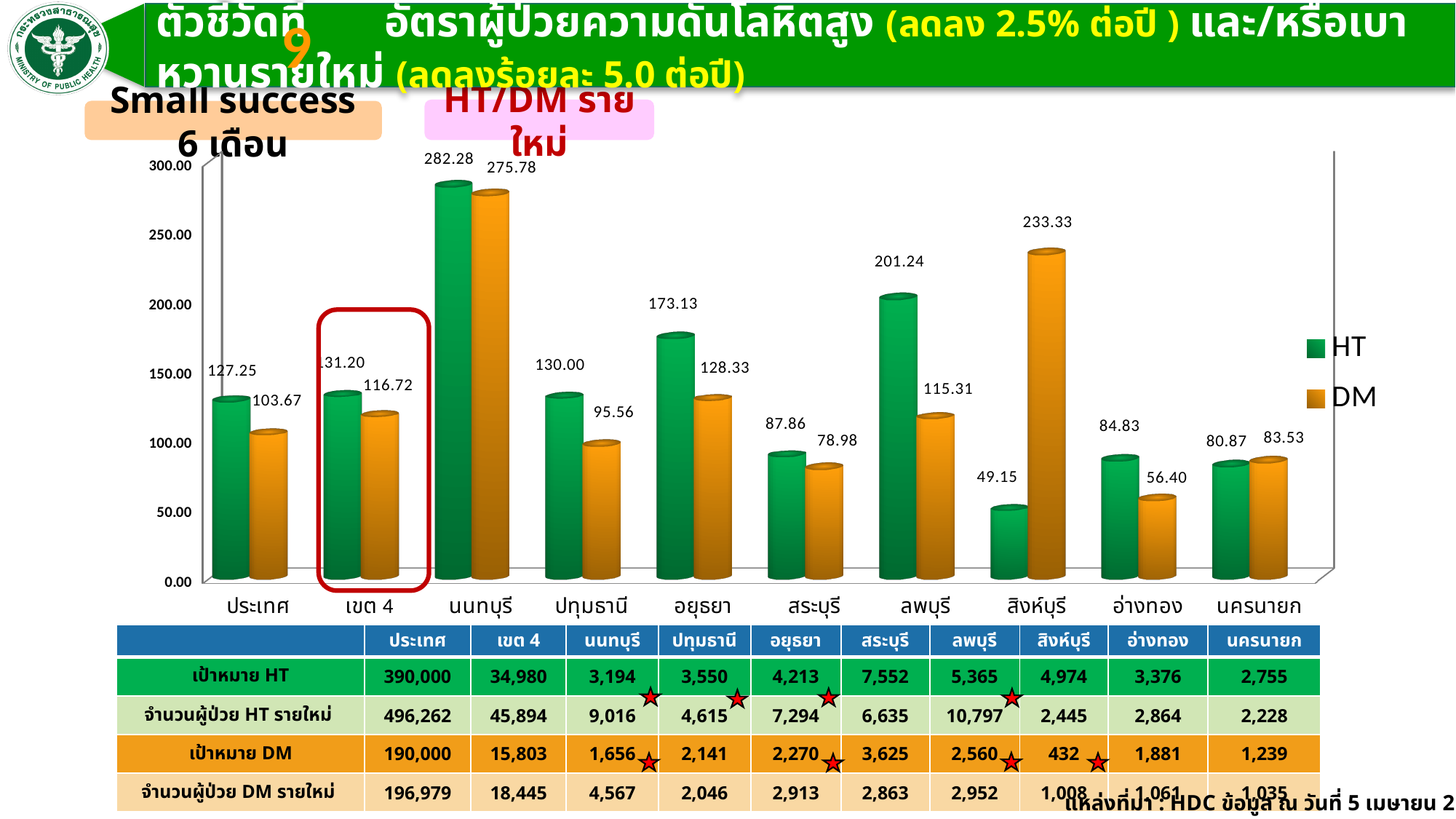
What is the HT value for นนทบุรี? 282.28 What is the HT value for เขต 4? 131.20 What is the DM value for ประเทศ? 103.67 Which category has the highest HT value? นนทบุรี What kind of chart is shown on the slide? Bar chart How many categories are shown on the x axis of the chart? 10 Which category has the lowest HT value? สิงห์บุรี What is the difference between the HT and DM values for ลพบุรี? 85.93 How many series does the chart legend list? 2 Which category has the lowest DM value? อ่างทอง What is the DM value for สิงห์บุรี? 233.33 Which is larger for สิงห์บุรี, the HT value or the DM value? DM